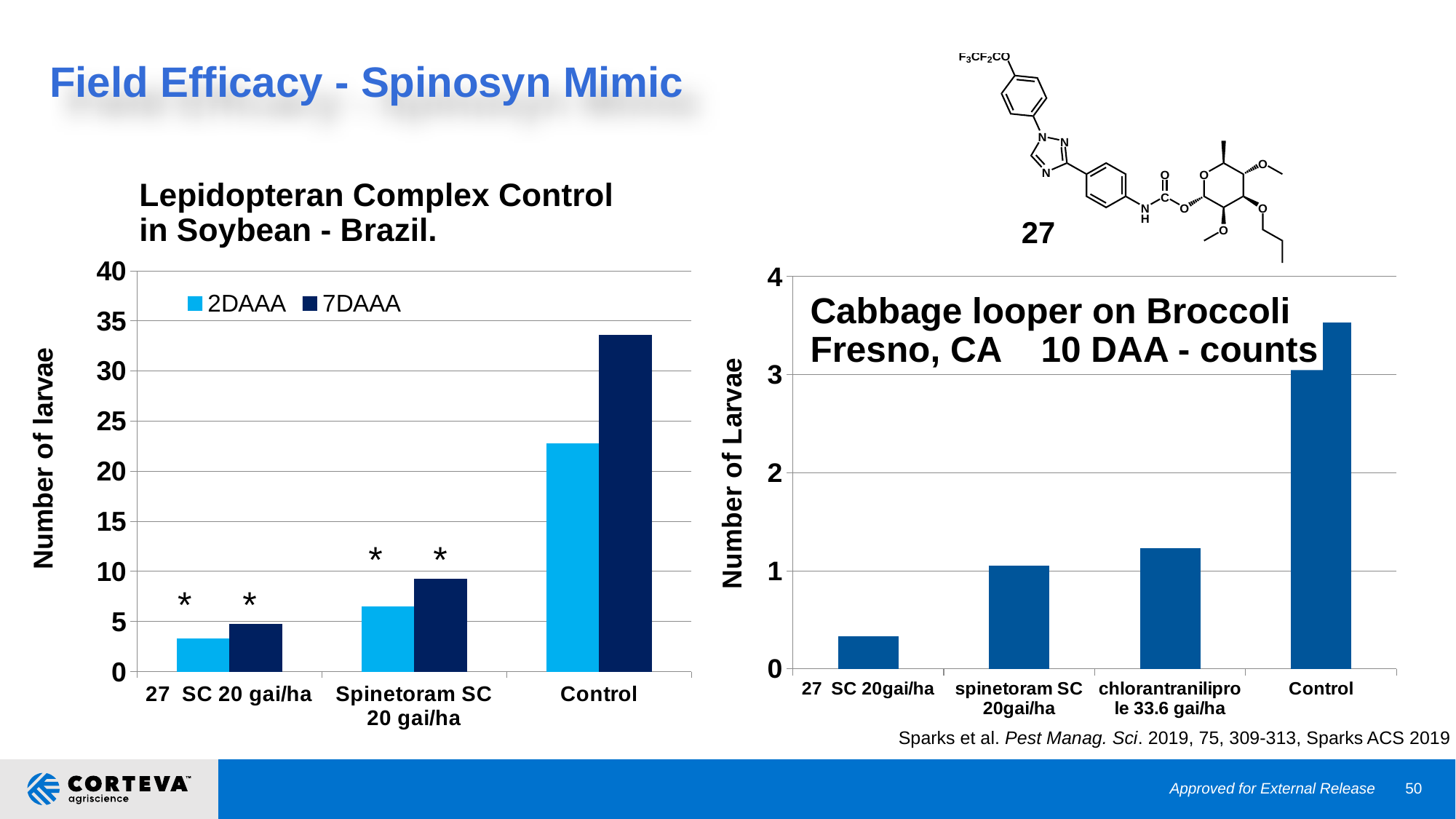
In the 'Lepidopteran Complex Control in Soybean - Brazil.' chart, which category has the highest 7DAAA value? Control How many treatment categories are shown on the x axis of the 'Lepidopteran Complex Control in Soybean - Brazil.' chart? 3 In the 'Lepidopteran Complex Control in Soybean - Brazil.' chart, which category has the lowest 2DAAA value? 27 SC 20 gai/ha In the 'Lepidopteran Complex Control in Soybean - Brazil.' chart, which is larger for Control: the 2DAAA value or the 7DAAA value? 7DAAA What kind of chart is the 'Lepidopteran Complex Control in Soybean - Brazil.' chart? bar chart In the 'Cabbage looper on Broccoli Fresno, CA 10 DAA - counts' chart, is the value for Control greater or less than 3? greater How many categories are shown on the x axis of the 'Cabbage looper on Broccoli Fresno, CA 10 DAA - counts' chart? 4 How many series does the legend of the 'Lepidopteran Complex Control in Soybean - Brazil.' chart list? 2 In the 'Lepidopteran Complex Control in Soybean - Brazil.' chart, is the 2DAAA value for Spinetoram SC 20 gai/ha greater or less than 10? less What are the two legend entries on the 'Lepidopteran Complex Control in Soybean - Brazil.' chart? 2DAAA and 7DAAA In the 'Cabbage looper on Broccoli Fresno, CA 10 DAA - counts' chart, which category has the lowest number of larvae? 27 SC 20gai/ha In the 'Lepidopteran Complex Control in Soybean - Brazil.' chart, is the 7DAAA value for Control greater or less than 30? greater